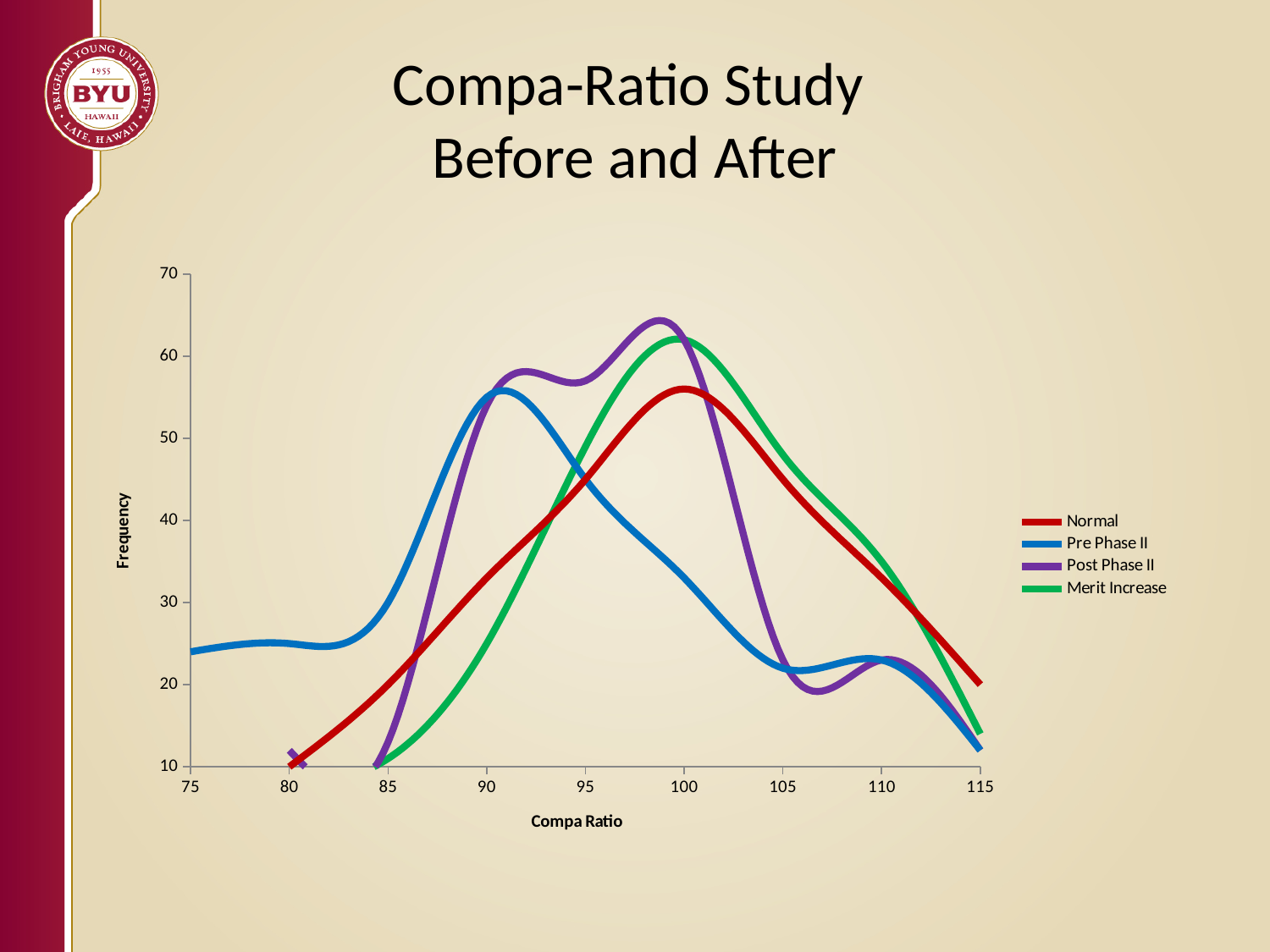
At a compa ratio of 100, which series has the larger value, Post Phase II or Pre Phase II? Post Phase II Is the value of the Merit Increase series at a compa ratio of 85 greater or less than 20? less What is the title of the chart's x axis? Compa Ratio Is the value of the Pre Phase II series at a compa ratio of 75 greater or less than 20? greater Does the Normal series rise or fall between a compa ratio of 100 and 115? Fall At a compa ratio of 90, which series has the larger value, Pre Phase II or Normal? Pre Phase II How many series does the legend list? 4 Is the value of the Normal series at a compa ratio of 100 greater or less than 50? greater Which series is drawn in green according to the legend? Merit Increase How many tick labels are shown on the x axis? 9 What kind of chart is shown on the slide? Line chart